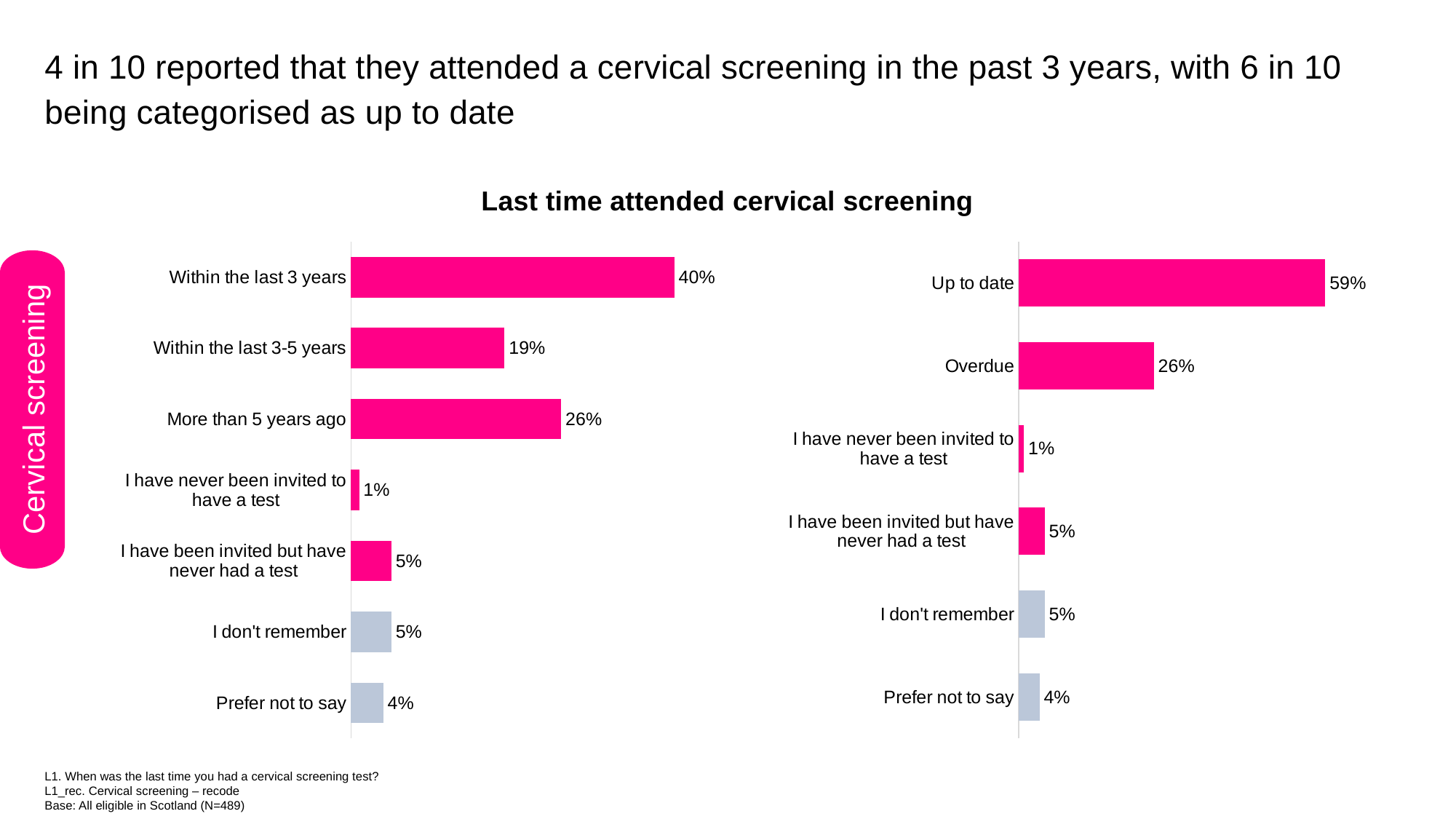
How many categories are shown in the right chart? 6 In the left chart, what is the value for 'More than 5 years ago'? 26% In the left chart, what is the difference between 'Within the last 3 years' and 'Within the last 3-5 years'? 21 percentage points In the left chart, which is larger: 'Within the last 3-5 years' or 'More than 5 years ago'? More than 5 years ago In the left chart, which category has the highest value? Within the last 3 years In the left chart, what percentage reported attending a cervical screening within the last 3 years? 40% In the right chart, what is the difference between 'Up to date' and 'Overdue'? 33 percentage points In the left chart, which category has the lowest value? I have never been invited to have a test How many categories are shown in the left chart? 7 What type of chart is used on this slide? Bar chart In the right chart, what is the value for 'Overdue'? 26% In the right chart, what percentage are categorised as 'Up to date'? 59%